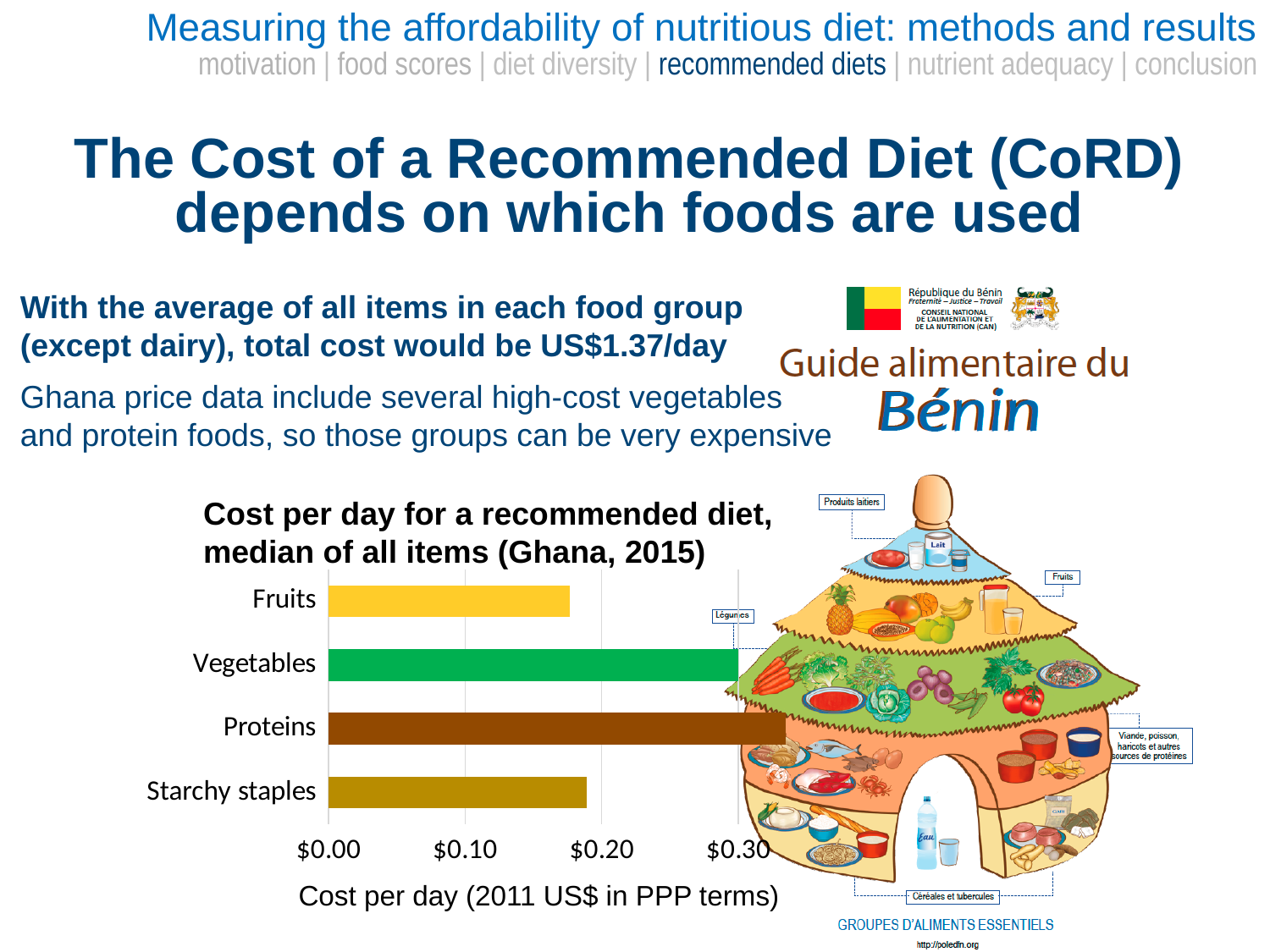
What is the title of the chart? Cost per day for a recommended diet, median of all items (Ghana, 2015) What is the label of the horizontal axis of the chart? Cost per day (2011 US$ in PPP terms) Which has a higher cost per day, Vegetables or Fruits? Vegetables What kind of chart is shown on the slide? bar chart Which has a higher cost per day, Proteins or Starchy staples? Proteins Is the cost per day for Starchy staples greater or less than $0.20? less Is the cost per day for Fruits greater or less than $0.20? less Which food group has the highest cost per day in the chart? Proteins Is the cost per day for Fruits greater or less than $0.10? greater How many food groups are plotted in the chart? 4